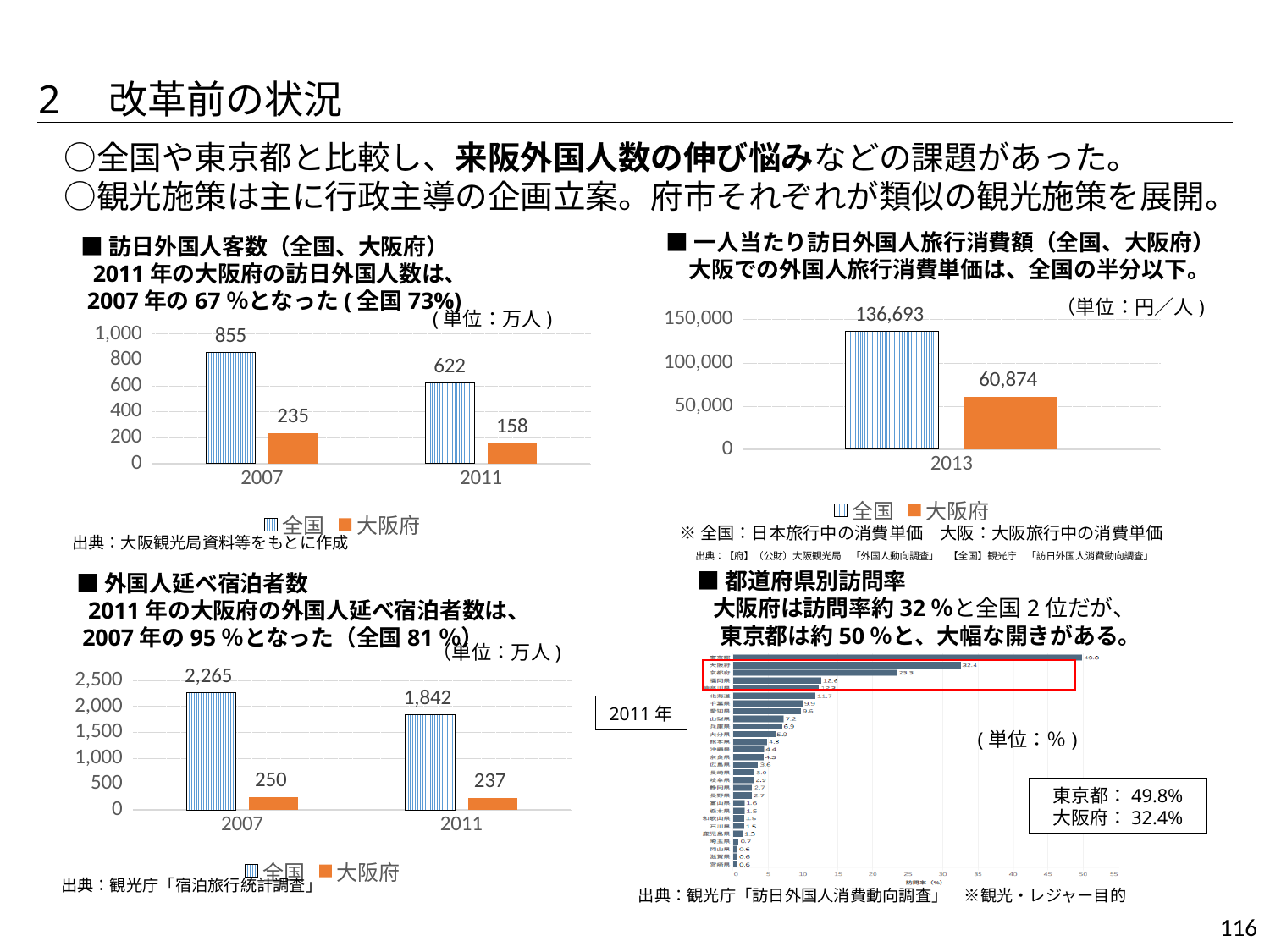
「外国人延べ宿泊者数」のグラフで、2011年の全国と大阪府ではどちらの値が大きいですか？ 全国 「訪日外国人客数（全国、大阪府）」のグラフで、2007年の全国の値はいくつですか？ 855 「外国人延べ宿泊者数」のグラフで、2011年の大阪府の値はいくつですか？ 237 「都道府県別訪問率」のグラフで、最も訪問率が高い都道府県はどこですか？ 東京都 「一人当たり訪日外国人旅行消費額（全国、大阪府）」のグラフで、全国と大阪府の値の差はいくつですか？ 75,819 「訪日外国人客数（全国、大阪府）」のグラフで、2011年の大阪府の値はいくつですか？ 158 「一人当たり訪日外国人旅行消費額（全国、大阪府）」のグラフで、2013年の全国の値はいくつですか？ 136,693 「訪日外国人客数（全国、大阪府）」のグラフで、大阪府の値は2007年から2011年にかけて増加していますか、減少していますか？ 減少 「外国人延べ宿泊者数」のグラフの凡例には、いくつの系列がありますか？ 2 「外国人延べ宿泊者数」のグラフで、2007年の全国の値はいくつですか？ 2,265 「訪日外国人客数（全国、大阪府）」のグラフで、全国の2007年と2011年の値の差はいくつですか？ 233 「一人当たり訪日外国人旅行消費額（全国、大阪府）」のグラフで、2013年の大阪府の値はいくつですか？ 60,874